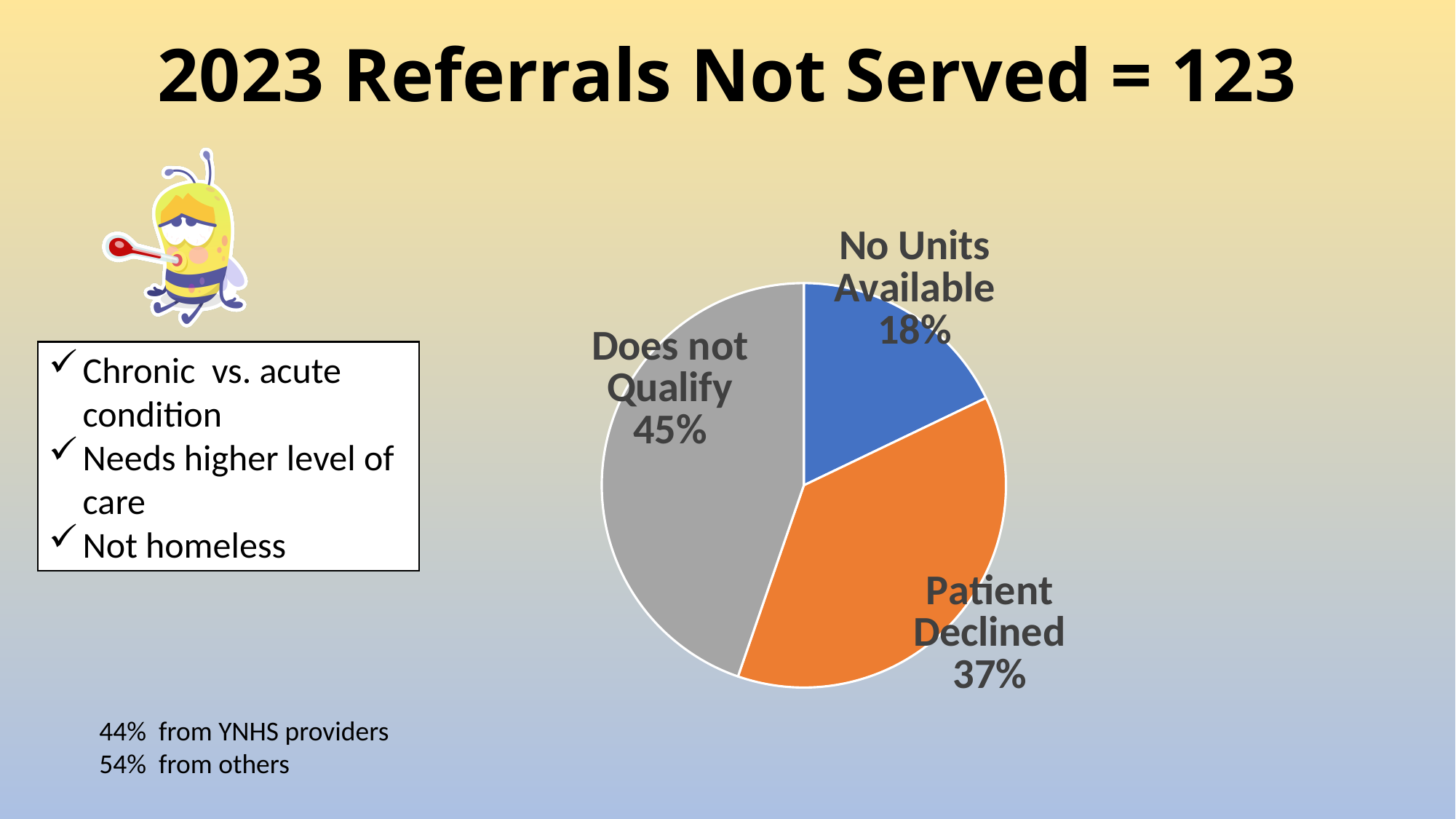
What is the difference in percentage points between the Does not Qualify slice and the Patient Declined slice? 8 How many slices does the pie chart have? 3 What kind of chart is shown on the slide? Pie chart What is the title of the slide containing the pie chart? 2023 Referrals Not Served = 123 Which slice of the pie is the largest? Does not Qualify What share of the pie is labelled Does not Qualify? 45% What colour is the Patient Declined slice? Orange What share of the pie is labelled No Units Available? 18% What is the difference in percentage points between the Patient Declined slice and the No Units Available slice? 19 Which slice of the pie is the smallest? No Units Available What share of the pie is labelled Patient Declined? 37% Which is larger, the Patient Declined slice or the No Units Available slice? Patient Declined